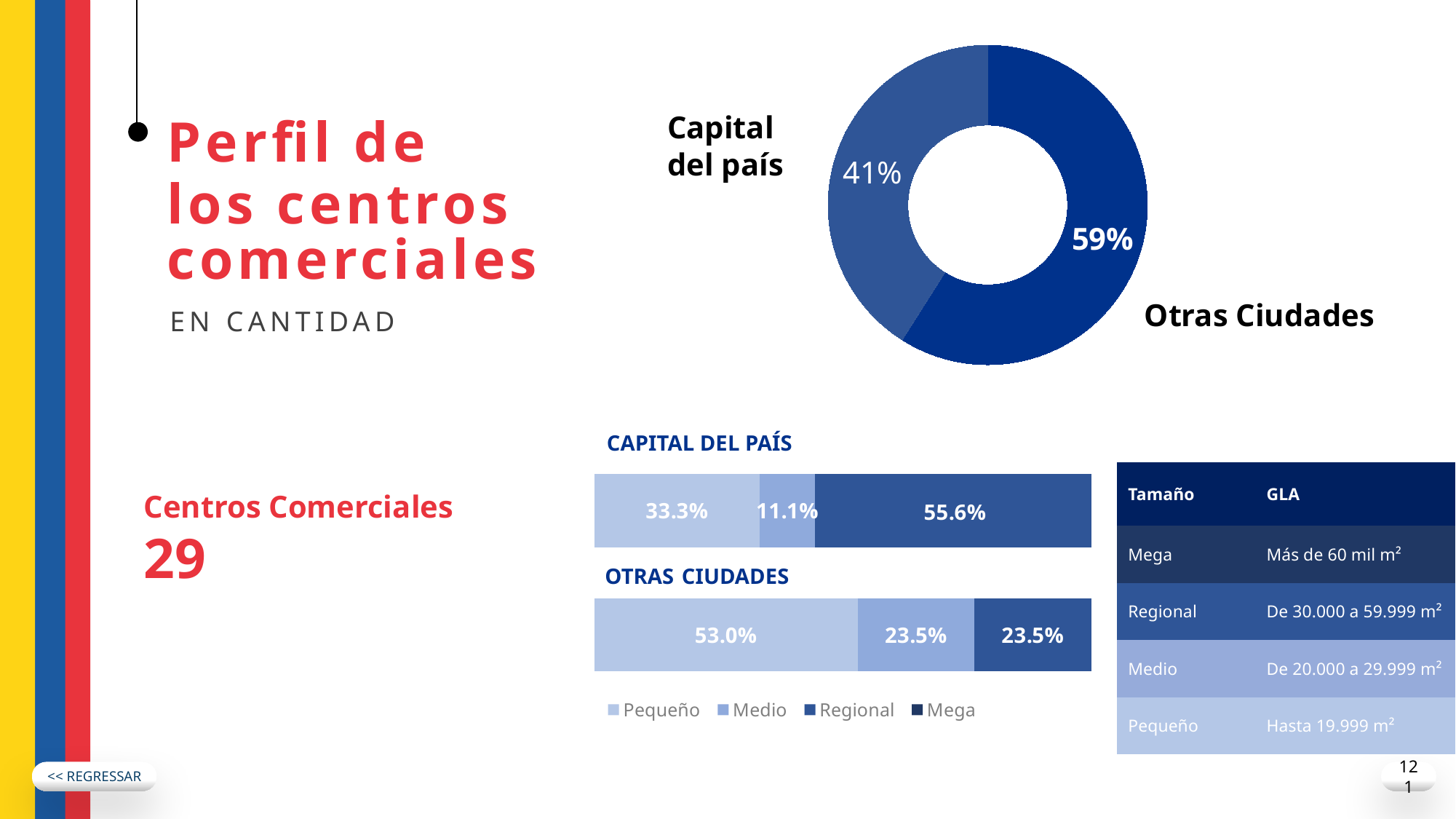
In the CAPITAL DEL PAÍS stacked bar, what is the value of the Medio segment? 11.1% In the OTRAS CIUDADES stacked bar, what is the value of the Pequeño segment? 53.0% In the donut chart at the top, which category has the larger share, Capital del país or Otras Ciudades? Otras Ciudades What type of chart is the one at the top of the slide showing Capital del país and Otras Ciudades? Donut (pie) chart In the CAPITAL DEL PAÍS stacked bar, what is the value of the largest segment? 55.6% In the OTRAS CIUDADES stacked bar, what is the value of the Medio segment? 23.5% In the donut chart at the top, how many percentage points larger is Otras Ciudades than Capital del país? 18 How many series does the legend below the stacked bar charts list? 4 In the donut chart at the top, what share is labelled for Otras Ciudades? 59% In the donut chart at the top, what share is labelled for Capital del país? 41% In the CAPITAL DEL PAÍS stacked bar, what is the value of the Pequeño segment? 33.3% Which has a larger Pequeño share, CAPITAL DEL PAÍS or OTRAS CIUDADES? OTRAS CIUDADES